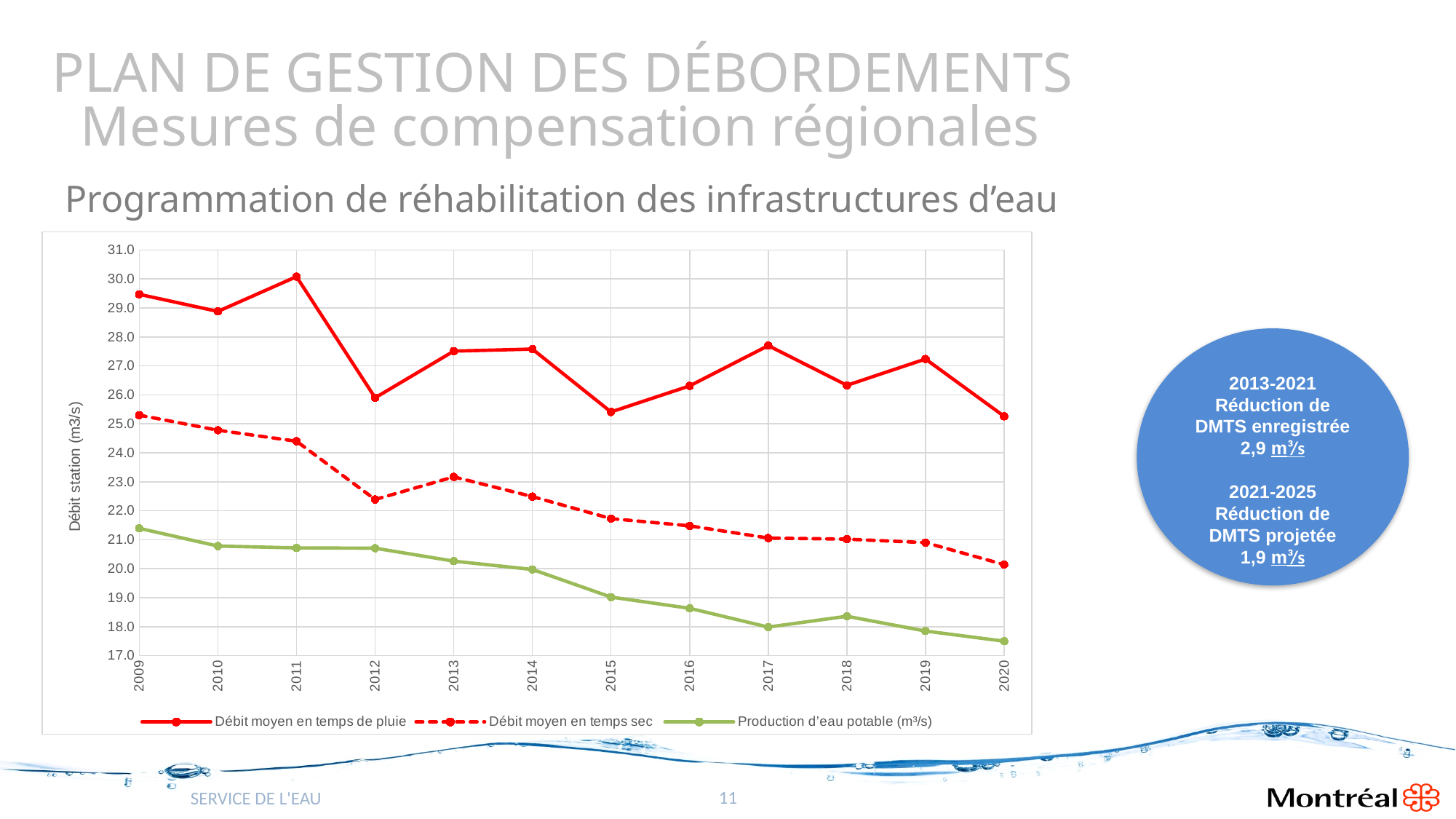
Is the value for Débit moyen en temps sec in 2012 greater or less than 23.0? less What is the label of the chart's vertical axis? Débit station (m3/s) In which year is the value for Débit moyen en temps sec lowest? 2020 What kind of chart is shown on the slide? Line chart In which year is the value for Production d'eau potable (m³/s) highest? 2009 Does the value for Production d'eau potable (m³/s) generally rise or fall from 2009 to 2020? Fall Which is larger in 2017: Débit moyen en temps de pluie or Débit moyen en temps sec? Débit moyen en temps de pluie How many years are plotted along the x axis of the chart? 12 Is the value for Production d'eau potable (m³/s) in 2020 greater or less than 18.0? less Is the value for Débit moyen en temps de pluie in 2009 greater or less than 29.0? greater How many series does the chart legend list? 3 In which year is the value for Débit moyen en temps de pluie highest? 2011